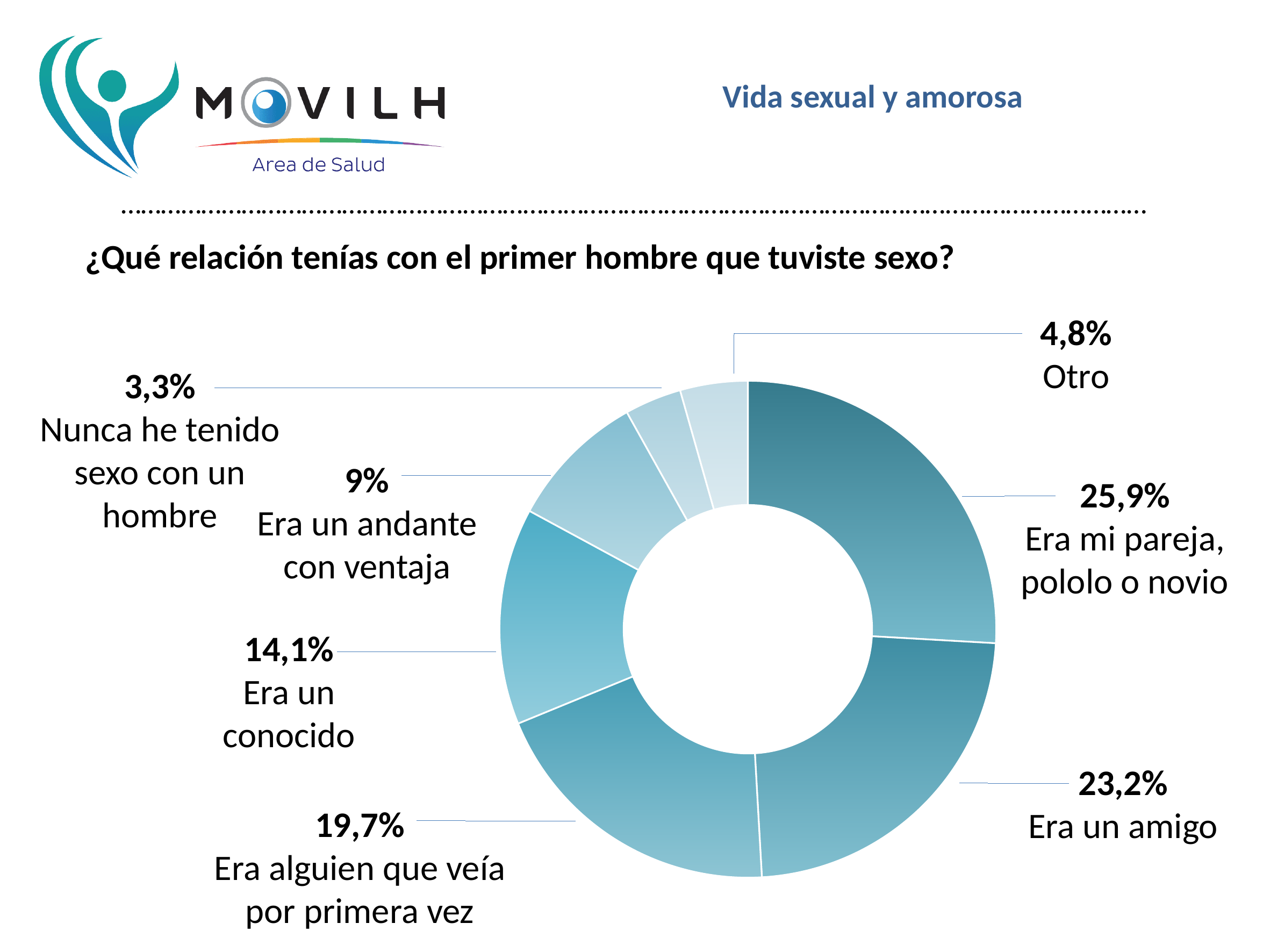
What percentage is shown for "Era un amigo"? 23,2% What percentage of respondents answered "Era mi pareja, pololo o novio"? 25,9% What question does the chart answer, according to the title above it? ¿Qué relación tenías con el primer hombre que tuviste sexo? What is the value for "Nunca he tenido sexo con un hombre"? 3,3% What is the value for "Era alguien que veía por primera vez"? 19,7% What is the difference between the shares for "Era mi pareja, pololo o novio" and "Era un amigo"? 2,7% What kind of chart is shown on the slide? Doughnut chart How many categories are shown in the chart? 7 Which category has the largest share of the chart? Era mi pareja, pololo o novio Which category has the smallest share of the chart? Nunca he tenido sexo con un hombre What percentage is shown for "Era un conocido"? 14,1% Which is larger: the share for "Era un conocido" or the share for "Era un andante con ventaja"? Era un conocido